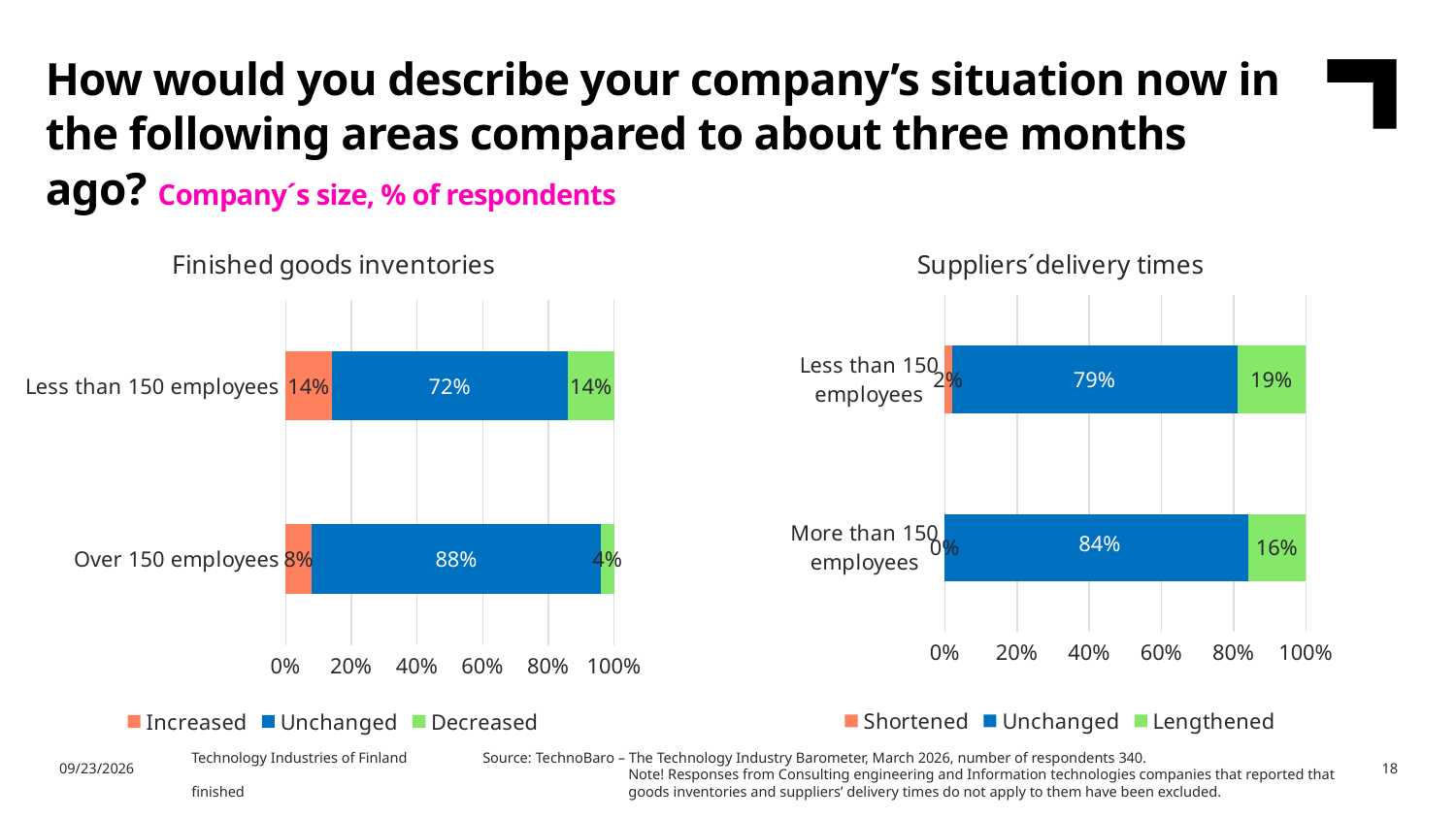
How many categories are shown in the 'Finished goods inventories' chart? 2 In the 'Finished goods inventories' chart, what percentage of companies with less than 150 employees reported 'Unchanged'? 72% In the 'Finished goods inventories' chart, what is the total of the stacked bar for less than 150 employees? 100% How many series does the legend of the 'Suppliers´delivery times' chart list? 3 In the 'Suppliers´delivery times' chart, what percentage of companies with more than 150 employees reported 'Unchanged'? 84% What are the legend entries of the 'Finished goods inventories' chart? Increased, Unchanged, Decreased In the 'Finished goods inventories' chart, which company size has the higher 'Decreased' share? Less than 150 employees In the 'Suppliers´delivery times' chart, what percentage of companies with less than 150 employees reported 'Lengthened'? 19% In the 'Finished goods inventories' chart, what percentage of companies with over 150 employees reported 'Increased'? 8% In the 'Finished goods inventories' chart, what is the difference between the 'Unchanged' share for over 150 employees and for less than 150 employees? 16% In the 'Suppliers´delivery times' chart, which company size has the larger 'Lengthened' share? Less than 150 employees What kind of chart is the 'Suppliers´delivery times' chart? Stacked bar chart